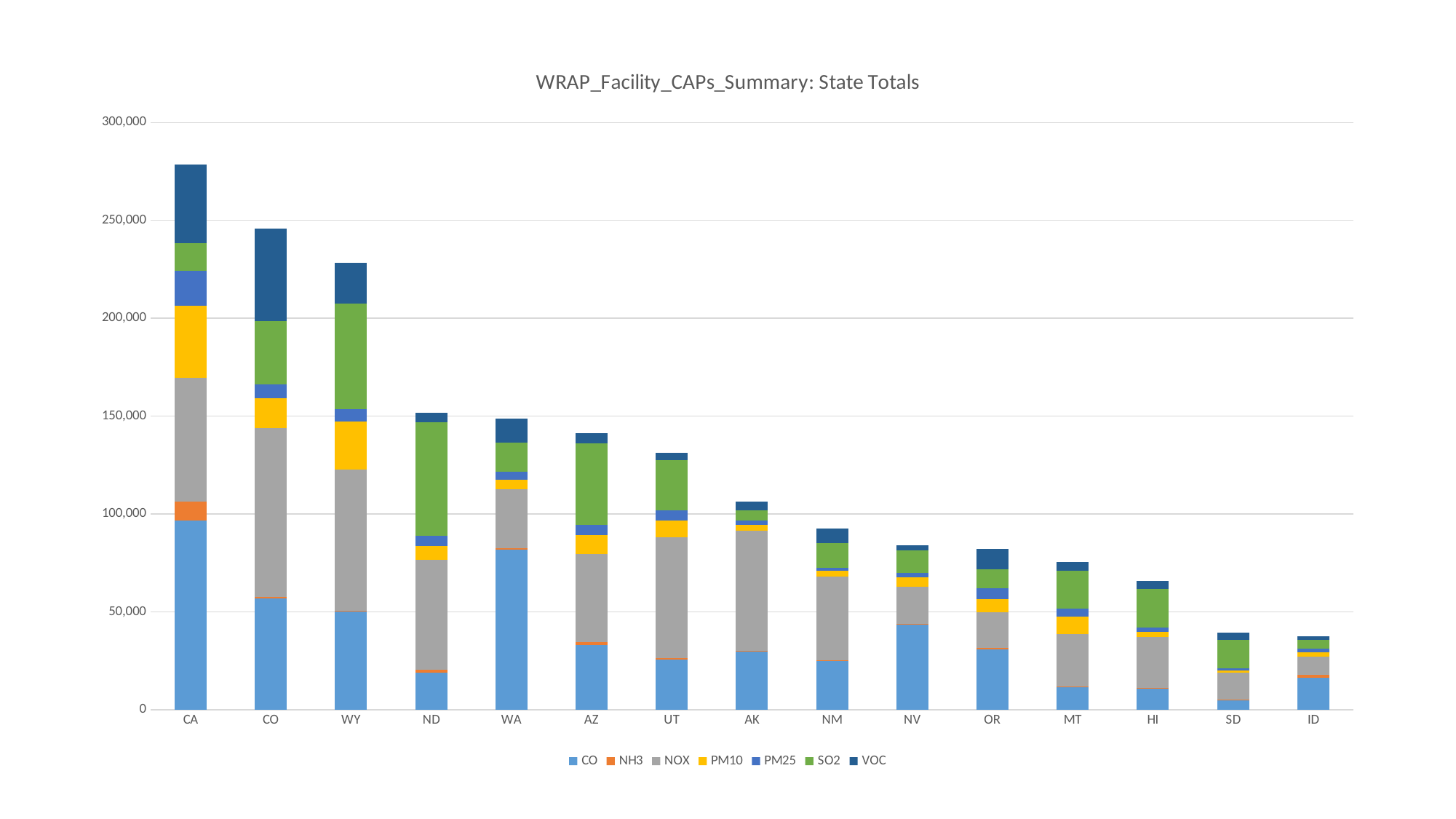
Is the total for SD greater or less than 50,000? less Is the total for CA greater or less than 250,000? greater How many states are shown on the x axis of the chart? 15 How many series does the legend list? 7 Which state has the larger total, CO or WY? CO Which state has the highest total stacked bar? CA Is the total for AZ greater or less than 150,000? less What is the title of the chart? WRAP_Facility_CAPs_Summary: State Totals Do the state totals generally rise or fall from left to right along the x axis? fall What kind of chart is shown on the slide? Stacked bar chart